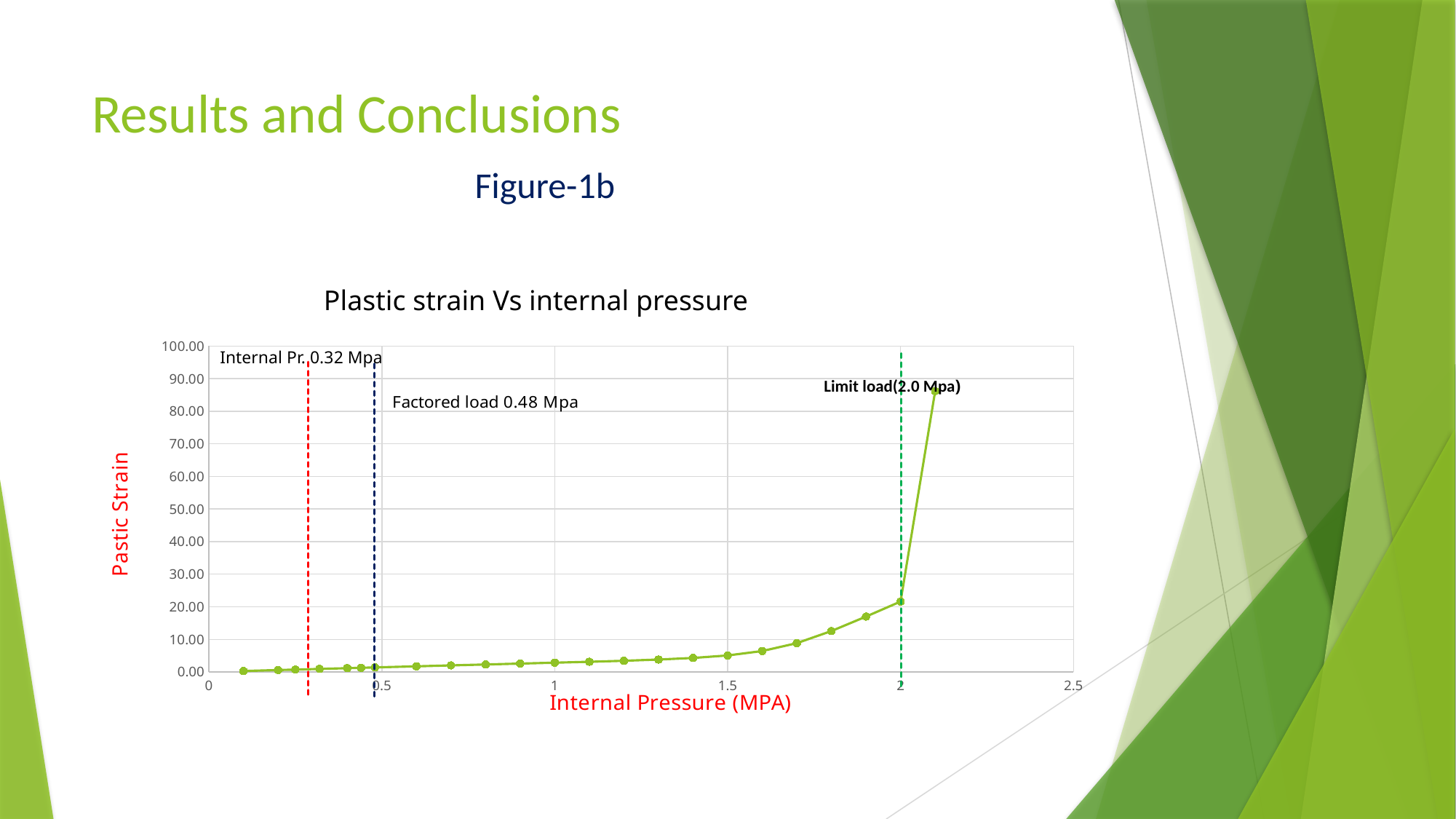
What is the maximum value shown on the y axis? 100.00 What kind of chart is shown on the slide? Line chart Is the plastic strain at the highest plotted pressure (about 2.1 MPA) greater or less than 80.00? greater Is the plastic strain at an internal pressure of 2 MPA greater or less than 30.00? less What is the title of the chart? Plastic strain Vs internal pressure Is the plastic strain at an internal pressure of 1.5 MPA greater or less than 10.00? less Does the plastic strain rise or fall as internal pressure increases along the x axis? Rise What pressure value is labelled as the factored load on the chart? 0.48 Mpa Which is larger, the plastic strain at 1.5 MPA or at 2 MPA? 2 MPA